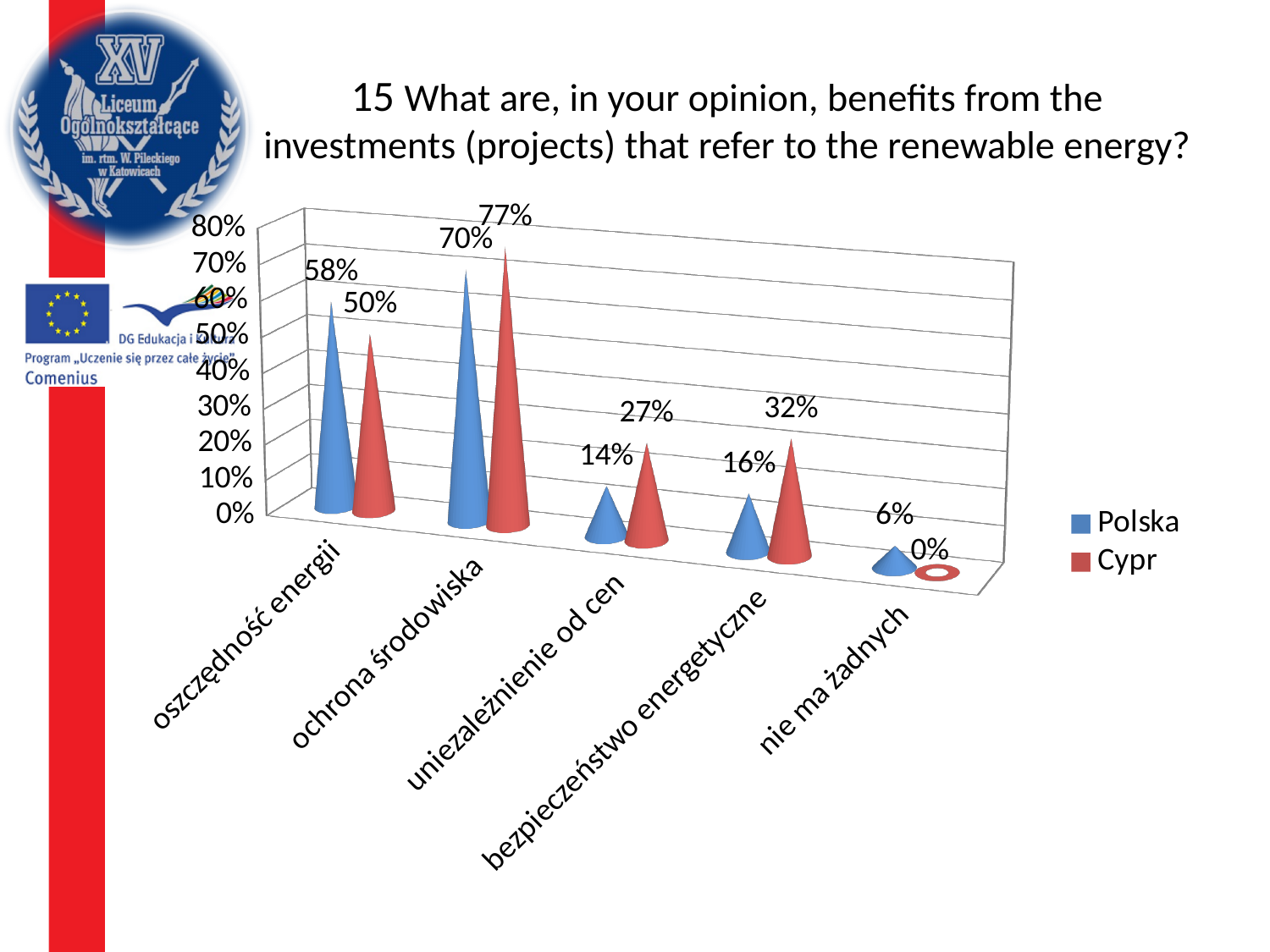
How many categories are shown on the x axis? 5 What is the value for Cypr for "bezpieczeństwo energetyczne"? 32% What is the difference between the Cypr and Polska values for "oszczędność energii"? 8% Which category has the highest value for Cypr? ochrona środowiska What is the value for Cypr for "uniezależnienie od cen"? 27% What kind of chart is shown on the slide? bar chart How many series does the legend list? 2 What is the value for Polska for "ochrona środowiska"? 70% What is the difference between the Cypr and Polska values for "bezpieczeństwo energetyczne"? 16% What is the value for Polska for "nie ma żadnych"? 6% Which is larger for "uniezależnienie od cen": the Polska value or the Cypr value? Cypr Which category has the lowest value for Polska? nie ma żadnych